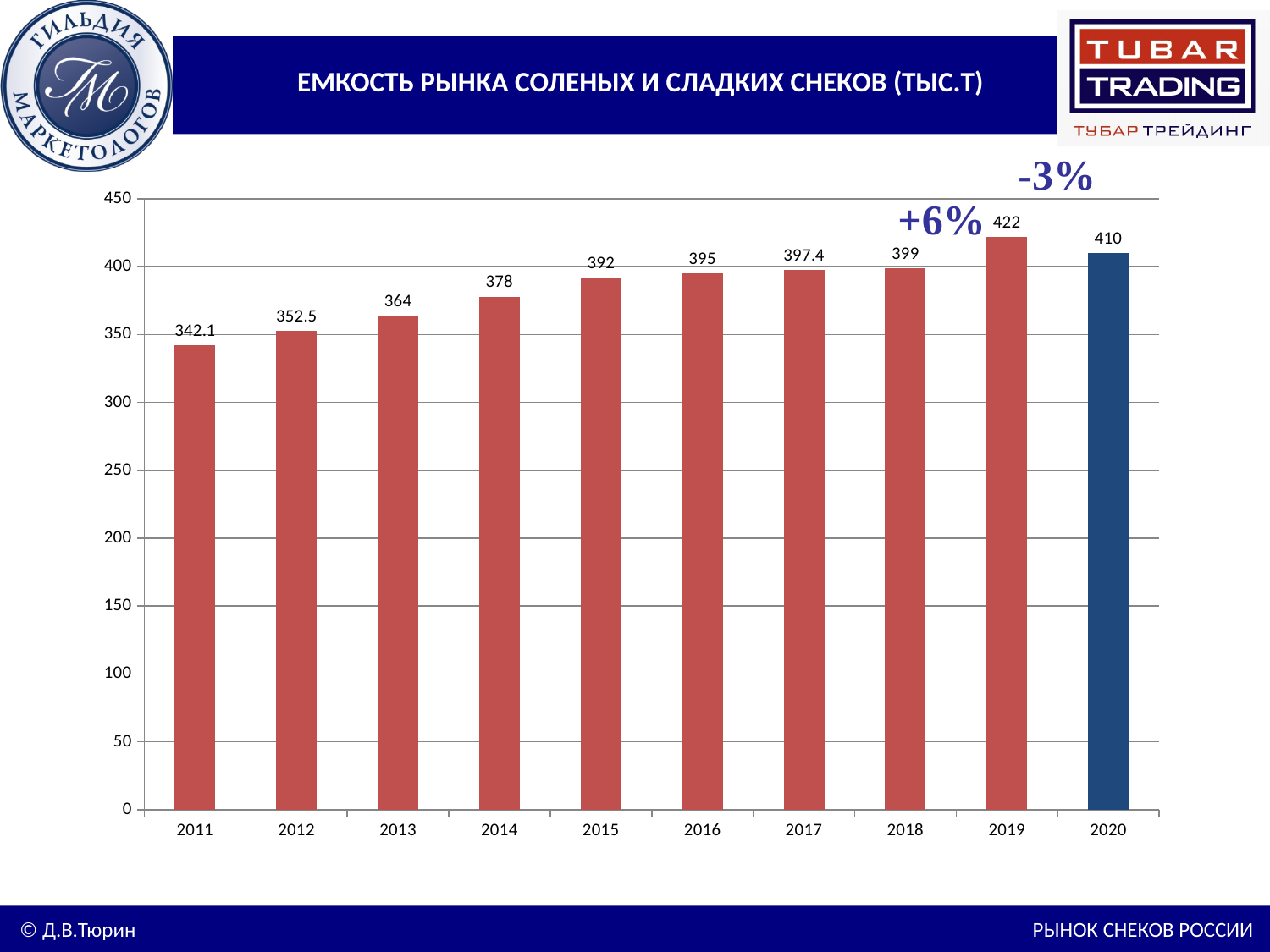
What is the value for 2020? 410 What is the difference between the values for 2019 and 2020? 12 What kind of chart is this? bar chart What is the value for 2017? 397.4 What is the value for 2011? 342.1 Which is larger, the value for 2014 or the value for 2013? 2014 What is the difference between the values for 2012 and 2011? 10.4 Which year has the lowest value? 2011 Is the value for 2015 greater or less than 350? greater Do the values rise or fall from 2011 to 2019? rise Which year has the highest value? 2019 How many years are shown on the x axis? 10